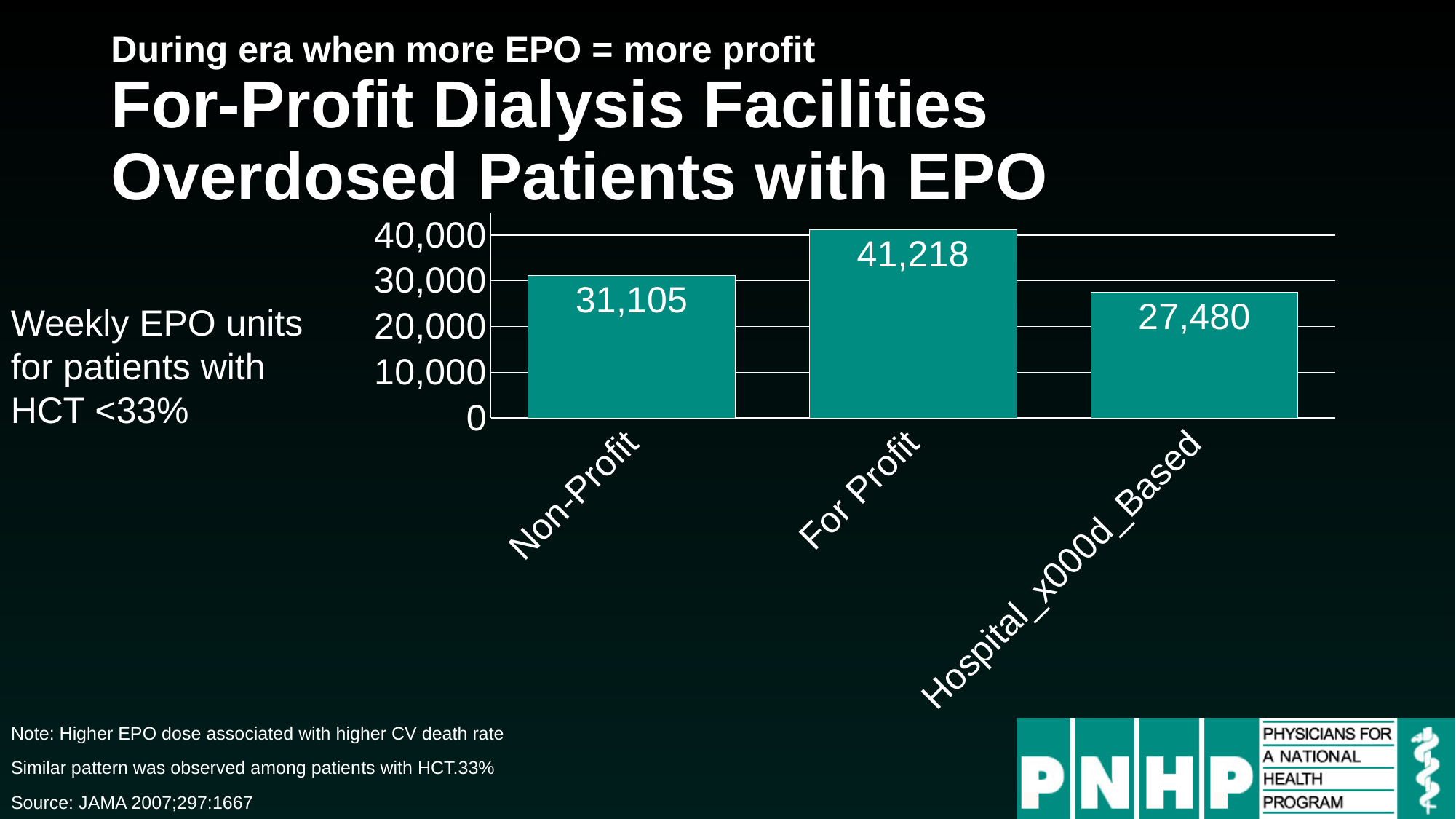
What is the weekly EPO units value for Hospital Based facilities? 27,480 How many facility types are shown in the chart? 3 What is the weekly EPO units value for Non-Profit facilities? 31,105 What kind of chart is shown on the slide? bar chart Which has a larger weekly EPO units value, Non-Profit or Hospital Based? Non-Profit What is the difference in weekly EPO units between For Profit and Non-Profit facilities? 10,113 What is the difference in weekly EPO units between Non-Profit and Hospital Based facilities? 3,625 What is the weekly EPO units value for For Profit facilities? 41,218 Is the value for For Profit greater or less than 40,000? greater Which facility type has the highest weekly EPO units? For Profit What does the chart measure, according to the label to its left? Weekly EPO units for patients with HCT <33% Which facility type has the lowest weekly EPO units? Hospital Based